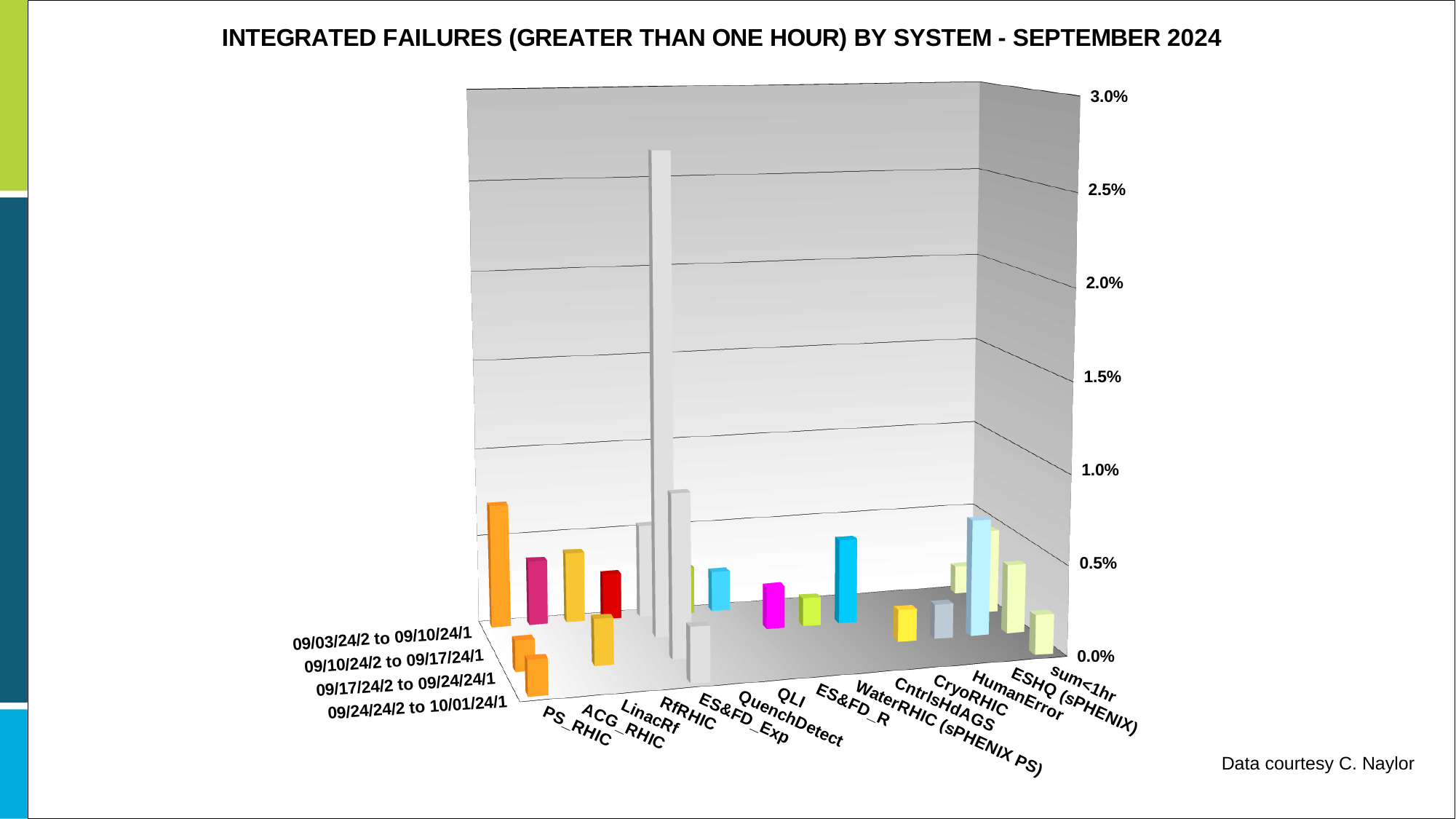
Which system has the highest bar in the chart? ES&FD_Exp What kind of chart is shown on the slide? bar chart What is the highest value shown on the vertical axis? 3.0% What is the last category listed on the x axis? sum<1hr How many weekly time periods are plotted in the chart? 4 Is the tallest bar for PS_RHIC greater or less than 1.0%? less What is the first time period listed on the depth axis? 09/03/24/2 to 09/10/24/1 Is the tallest bar for RfRHIC greater or less than 2.0%? less Which has the taller bar, RfRHIC or PS_RHIC? PS_RHIC What is the title of the chart? INTEGRATED FAILURES (GREATER THAN ONE HOUR) BY SYSTEM - SEPTEMBER 2024 How many system categories are shown along the x axis? 14